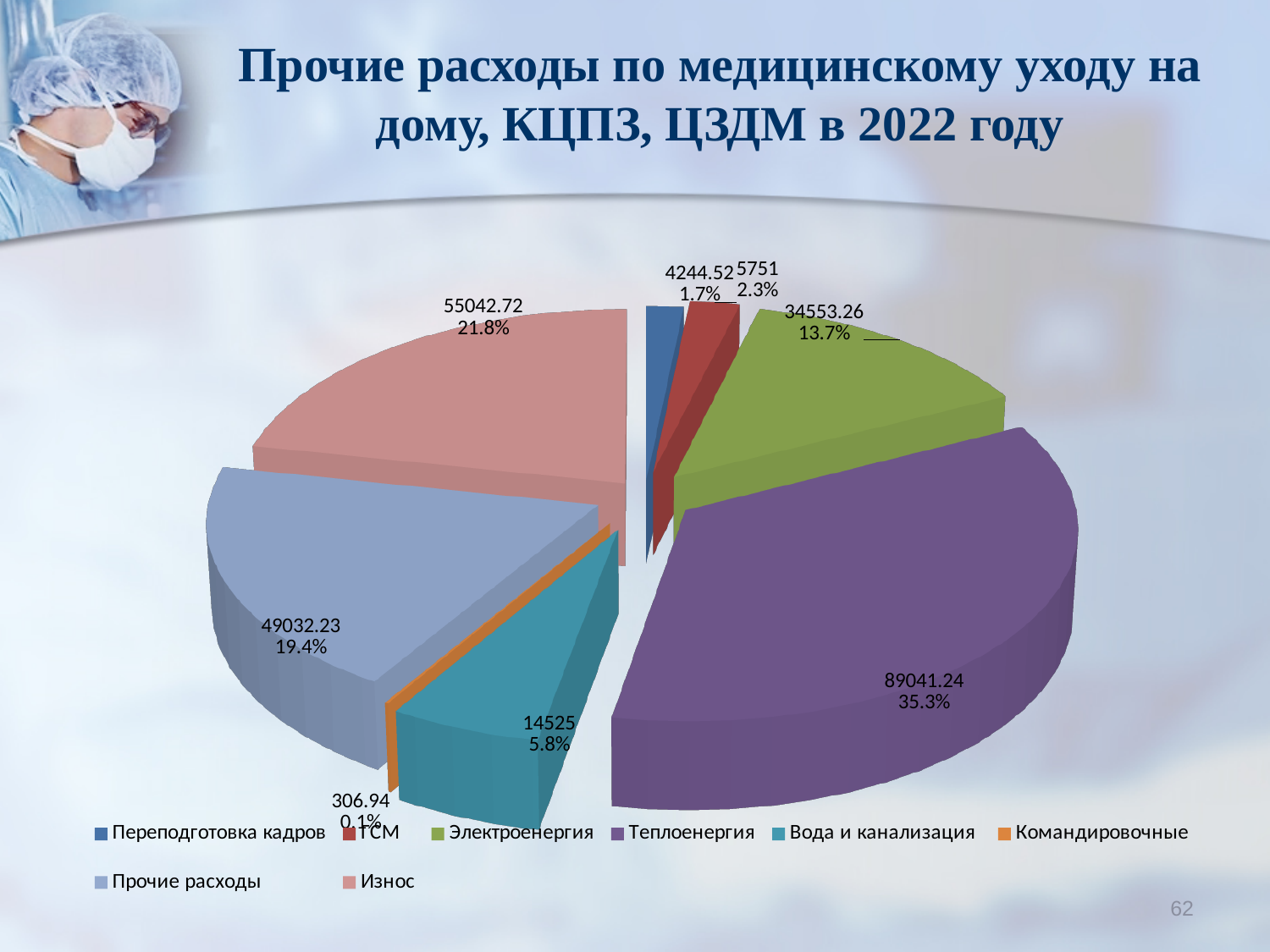
What is the value for Теплоенергия? 89041.24 How many categories does the pie chart have? 8 What is the title of the chart? Прочие расходы по медицинскому уходу на дому, КЦПЗ, ЦЗДМ в 2022 году What is the value for Вода и канализация? 14525 Which is larger, the value for ГСМ or the value for Переподготовка кадров? ГСМ What percentage is shown for Электроэнергия? 13.7% Which category has the largest slice of the pie? Теплоенергия Which category has the smallest slice of the pie? Командировочные What is the difference between the values for Износ and Прочие расходы? 6010.49 What share of the pie does Износ represent? 21.8% What type of chart is shown on the slide? Pie chart What is the value for Командировочные? 306.94